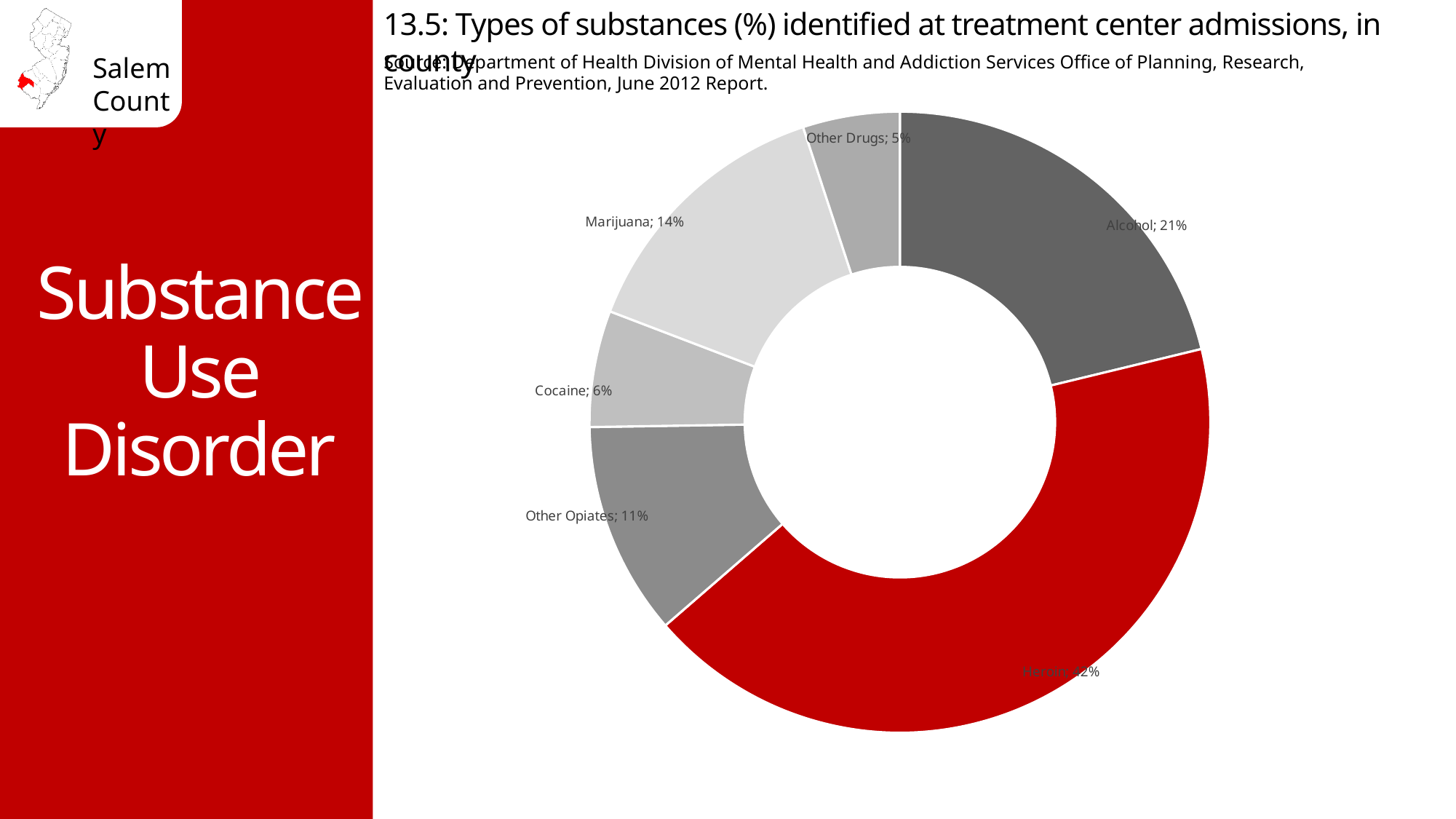
What is the difference in percentage points between Heroin and Alcohol? 21 Which slice of the chart is coloured red? Heroin What type of chart is used on this slide? Pie chart (doughnut) Which has a larger share, Marijuana or Other Opiates? Marijuana Which substance has the largest share of treatment center admissions? Heroin How many substance categories are shown in the chart? 6 What percentage of treatment center admissions identified Heroin? 42% What percentage of treatment center admissions identified Other Opiates? 11% Which substance has the smallest share of treatment center admissions? Other Drugs What percentage of treatment center admissions identified Alcohol? 21% What percentage of treatment center admissions identified Cocaine? 6% What percentage of treatment center admissions identified Marijuana? 14%